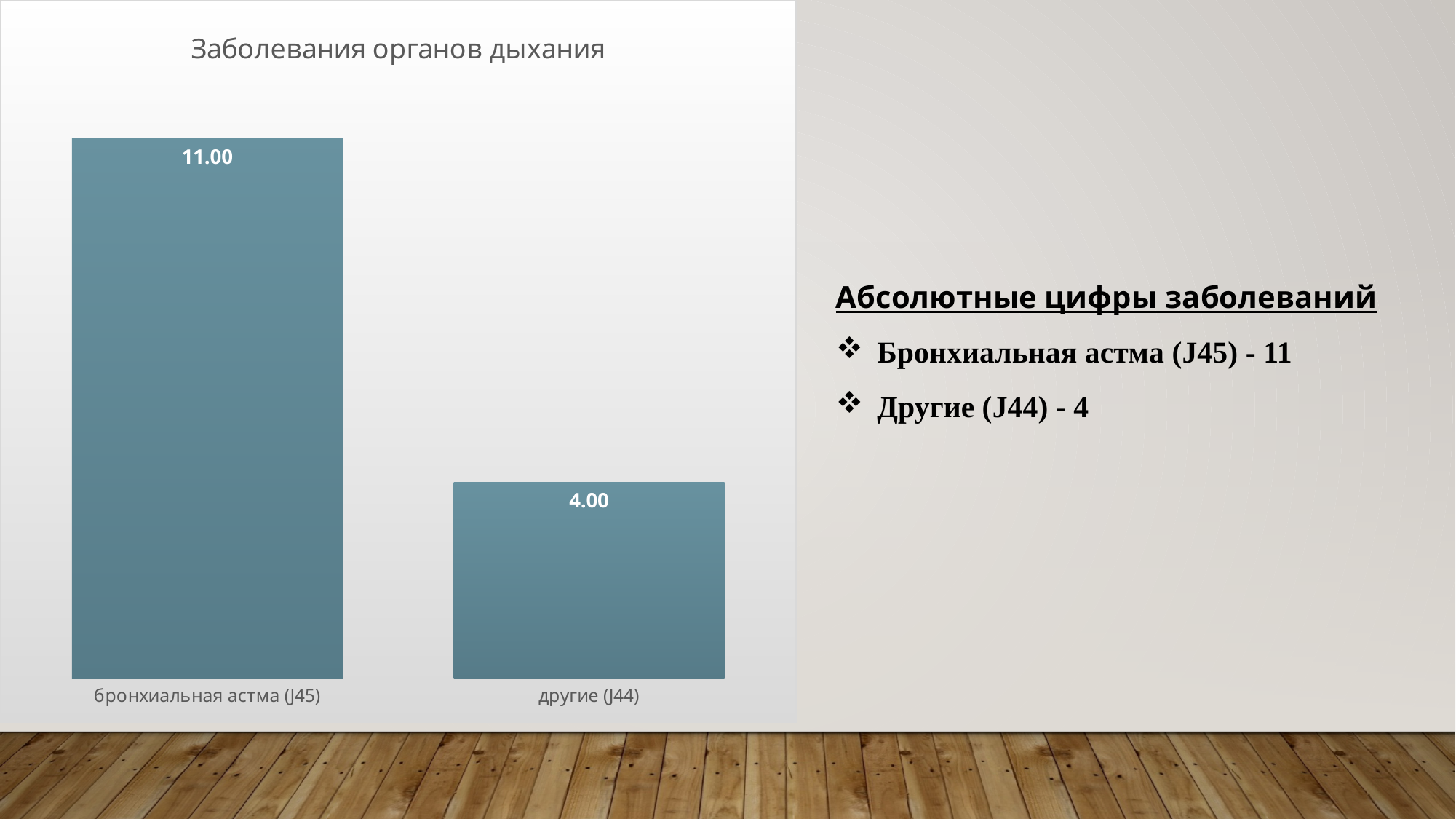
What is the difference between the values for бронхиальная астма (J45) and другие (J44)? 7.00 What kind of chart is shown on the slide? bar chart Which is larger: the value for бронхиальная астма (J45) or the value for другие (J44)? бронхиальная астма (J45) What is the value for бронхиальная астма (J45)? 11.00 What is the value for другие (J44)? 4.00 What is the title of the chart? Заболевания органов дыхания What is the total of the two values shown in the chart? 15.00 How many categories are shown in the chart? 2 Which category has the lowest value? другие (J44) Do the values rise or fall from left to right along the x axis? fall Which category has the highest value? бронхиальная астма (J45)